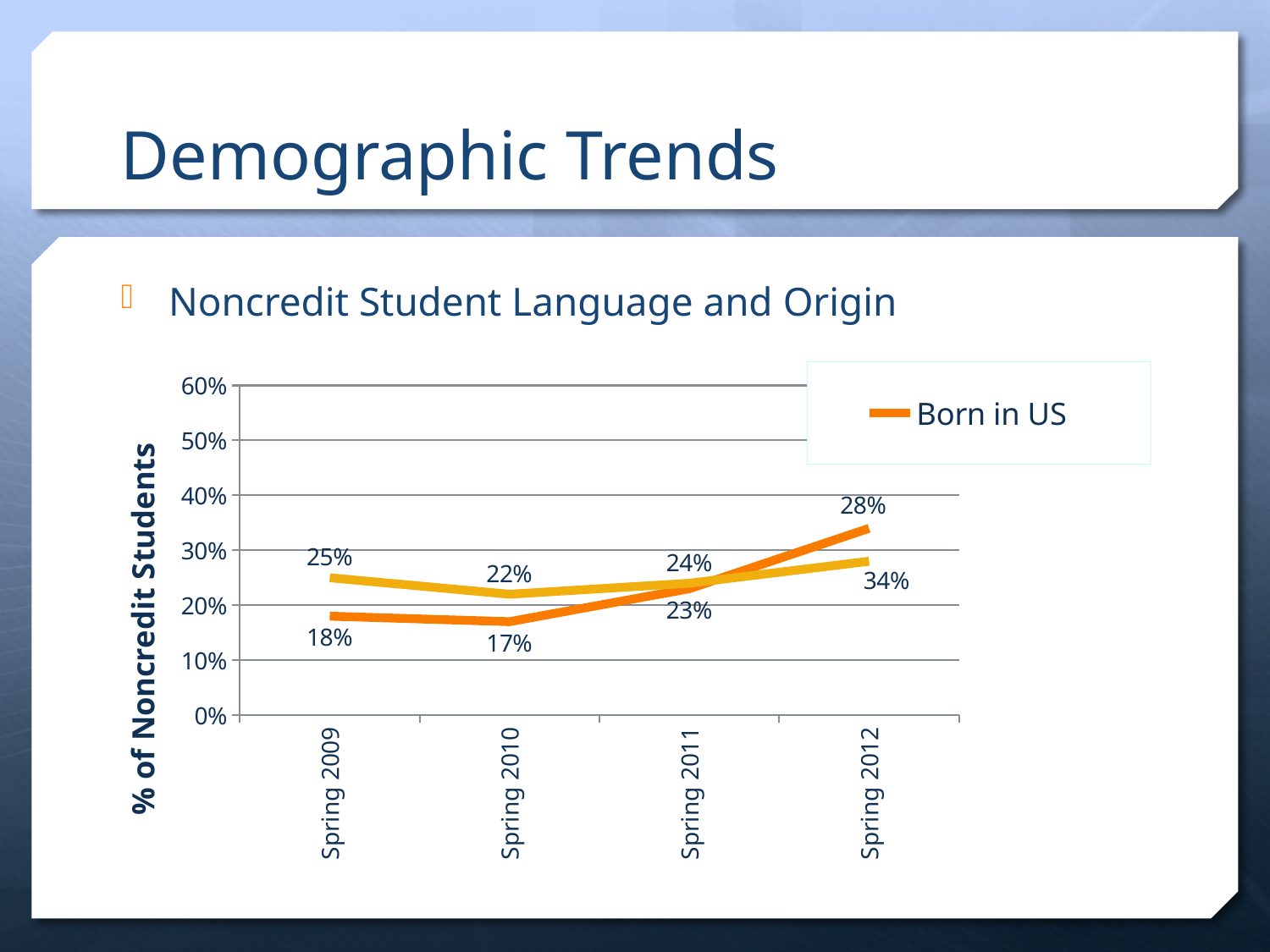
By how many percentage points did the Born in US value change from Spring 2009 to Spring 2012? 16 percentage points What is the Born in US value for Spring 2009? 18% What is the title of the vertical axis? % of Noncredit Students What is the Born in US value for Spring 2010? 17% What is the Born in US value for Spring 2011? 23% How many terms are shown on the x axis? 4 Does the Born in US line rise or fall from Spring 2010 to Spring 2012? rise In which term is the Born in US value highest? Spring 2012 In which term is the Born in US value lowest? Spring 2010 What is the Born in US value for Spring 2012? 34% What kind of chart is shown on the slide? line chart Which is larger for Born in US: the Spring 2011 value or the Spring 2012 value? Spring 2012